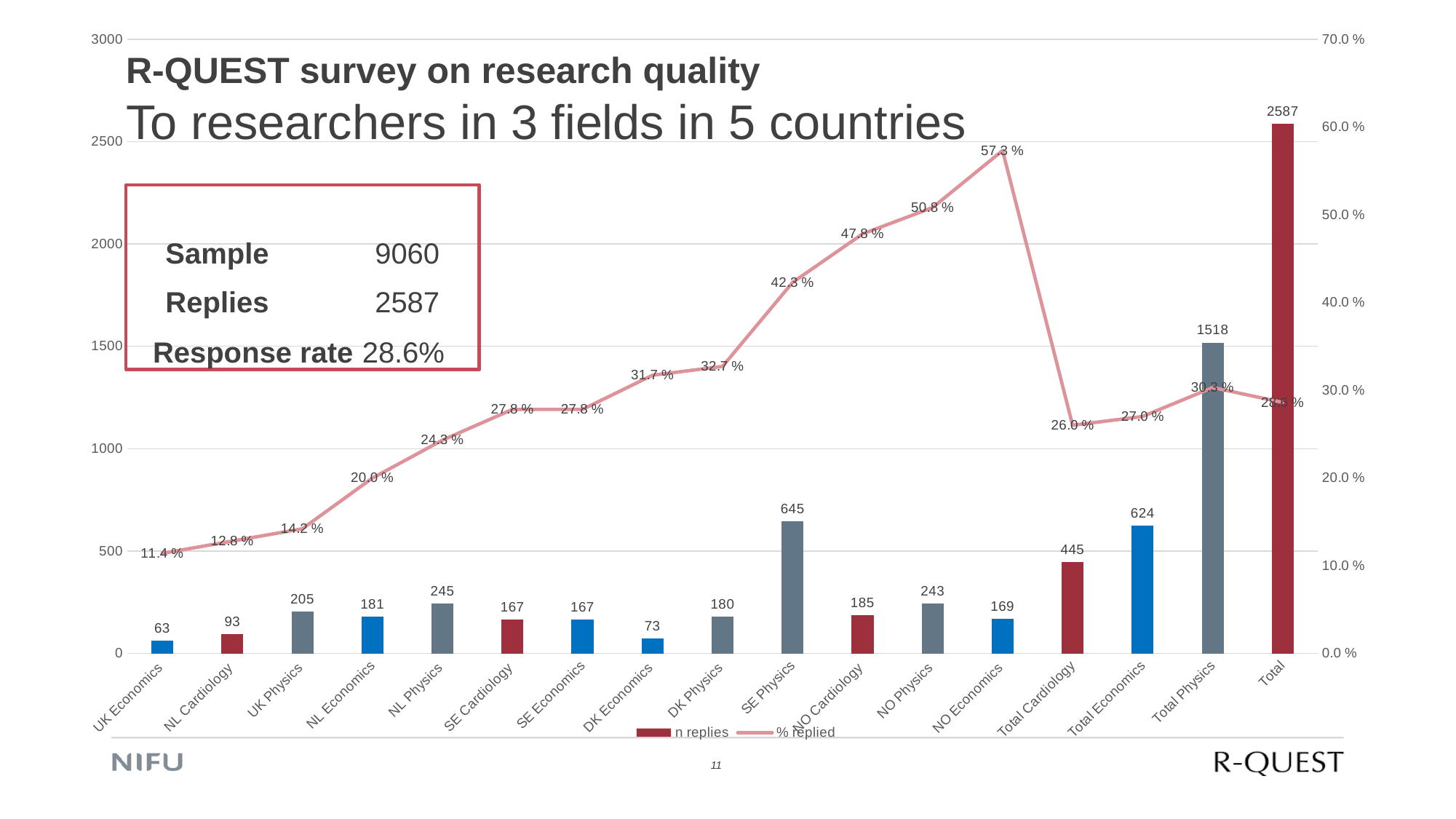
What is the number of replies for Total Physics? 1518 Which has more replies, NL Physics or NO Physics? NL Physics Which category has the highest % replied value? NO Economics How many categories are shown on the x axis? 17 What is the difference in number of replies between Total Economics and Total Cardiology? 179 What is the % replied value for NO Economics? 57.3 % Does the % replied line rise or fall from UK Economics to NO Economics? Rise Which category has the lowest number of replies? UK Economics Which category has the highest number of replies? Total How many series does the legend list? 2 What is the number of replies (n replies) for SE Physics? 645 What kind of chart is shown on the slide? Combined bar and line chart